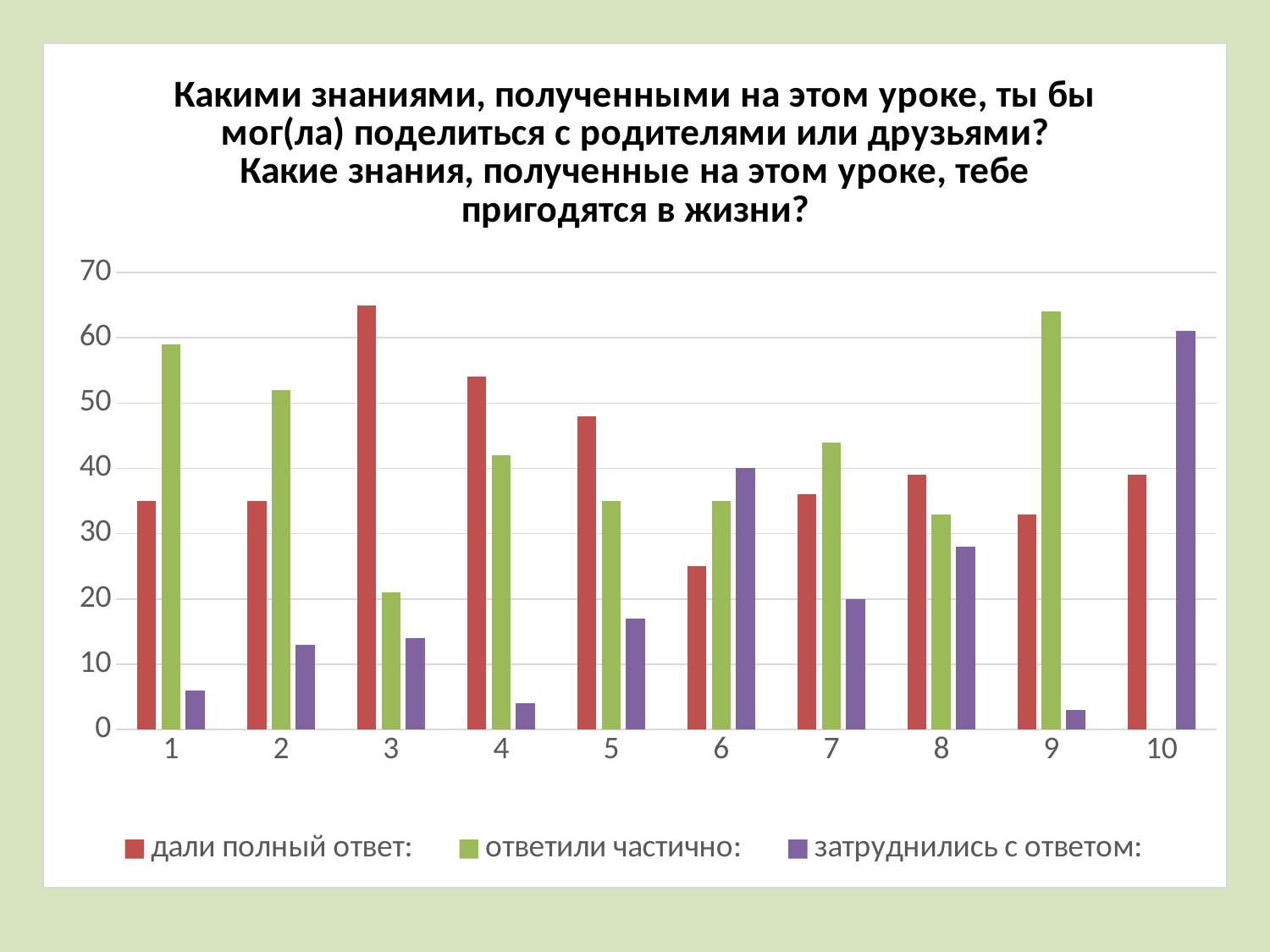
In category 6, which series has the larger value: "дали полный ответ:" or "затруднились с ответом:"? затруднились с ответом: Which colour represents the series "дали полный ответ:" in the legend? red Is the value for "дали полный ответ:" in category 6 greater or less than 30? less In category 1, which series has the larger value: "дали полный ответ:" or "ответили частично:"? ответили частично: For which category is the value of the series "затруднились с ответом:" the highest? 10 What kind of chart is shown on the slide? bar chart For which category is the value of the series "дали полный ответ:" the highest? 3 How many categories are shown along the x axis? 10 Is the value for "дали полный ответ:" in category 3 greater or less than 60? greater Is the value for "затруднились с ответом:" in category 1 greater or less than 10? less How many series does the legend list? 3